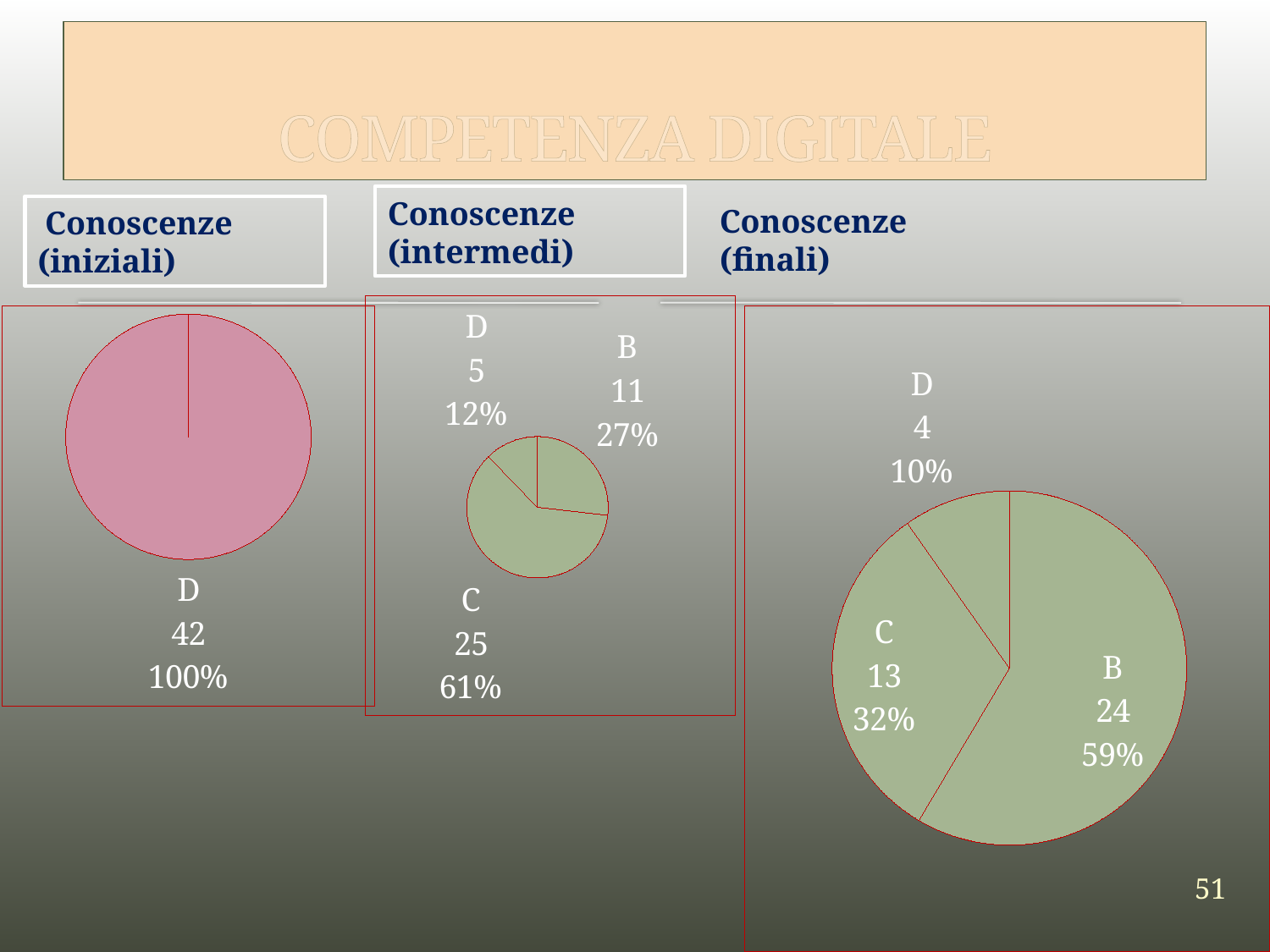
In the Conoscenze (intermedi) chart, what percentage is shown for B? 27% In the Conoscenze (finali) chart, which category has the largest slice? B In the Conoscenze (finali) chart, what value is shown for B? 24 How many slices does the Conoscenze (intermedi) pie chart have? 3 In the Conoscenze (finali) chart, which is larger, the value for C or the value for D? C In the Conoscenze (intermedi) chart, which category has the smallest slice? D In the Conoscenze (intermedi) chart, what value is shown for C? 25 What kind of chart is used for Conoscenze (iniziali)? pie chart In the Conoscenze (finali) chart, what percentage is shown for C? 32% In the Conoscenze (intermedi) chart, what is the difference between the values for C and B? 14 In the Conoscenze (iniziali) chart, what value is shown for D? 42 In the Conoscenze (iniziali) chart, what share of the pie does D hold? 100%